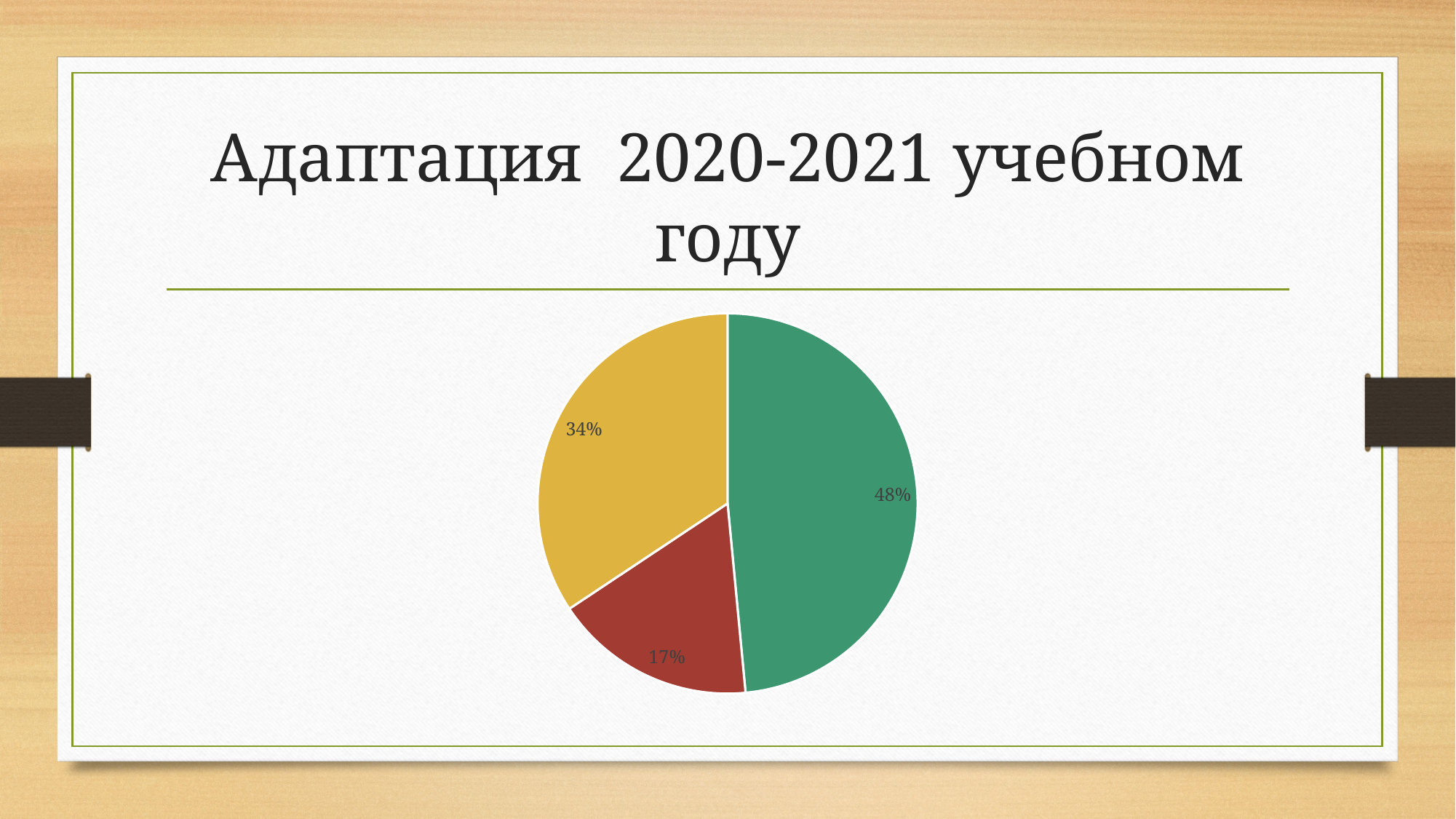
What is the difference in percentage points between the green slice and the yellow slice? 14 What is the title of the slide containing the pie chart? Адаптация 2020-2021 учебном году Which slice of the pie chart is the smallest? the red slice (17%) What is the difference in percentage points between the yellow slice and the red slice? 17 What kind of chart is shown on the slide? pie chart How many slices does the pie chart have? 3 Which slice of the pie chart is the largest? the green slice (48%) Which is larger in the pie chart, the yellow slice or the red slice? the yellow slice What percentage is shown on the red slice of the pie chart? 17% What colour is the slice labelled 17% in the pie chart? red What percentage is shown on the yellow slice of the pie chart? 34% What percentage is shown on the green slice of the pie chart? 48%